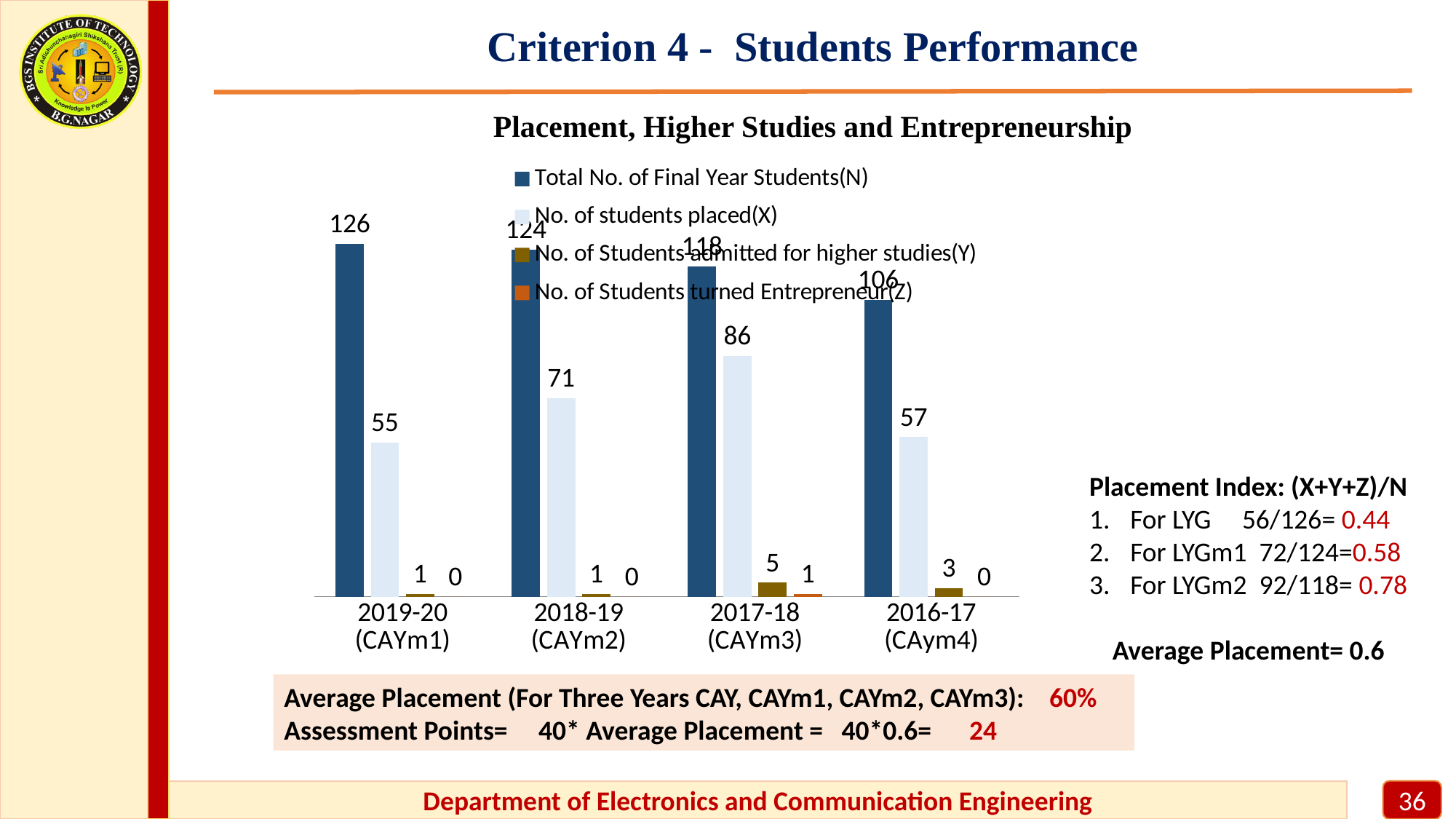
How many year categories are shown on the x axis of the chart? 4 Which year has the lowest Total No. of Final Year Students(N)? 2016-17 (CAym4) Which is larger: the No. of students placed(X) for 2019-20 (CAYm1) or for 2016-17 (CAym4)? 2016-17 (CAym4) Which year has the highest No. of students placed(X)? 2017-18 (CAYm3) What is the Total No. of Final Year Students(N) for 2019-20 (CAYm1)? 126 What is the No. of Students turned Entrepreneur(Z) for 2017-18 (CAYm3)? 1 What is the difference between the Total No. of Final Year Students(N) and the No. of students placed(X) for 2018-19 (CAYm2)? 53 Does the Total No. of Final Year Students(N) rise or fall from 2019-20 (CAYm1) to 2016-17 (CAym4) along the x axis? fall What type of chart is shown on the slide? bar chart What is the No. of Students admitted for higher studies(Y) for 2016-17 (CAym4)? 3 How many series does the chart legend list? 4 What is the No. of students placed(X) for 2017-18 (CAYm3)? 86